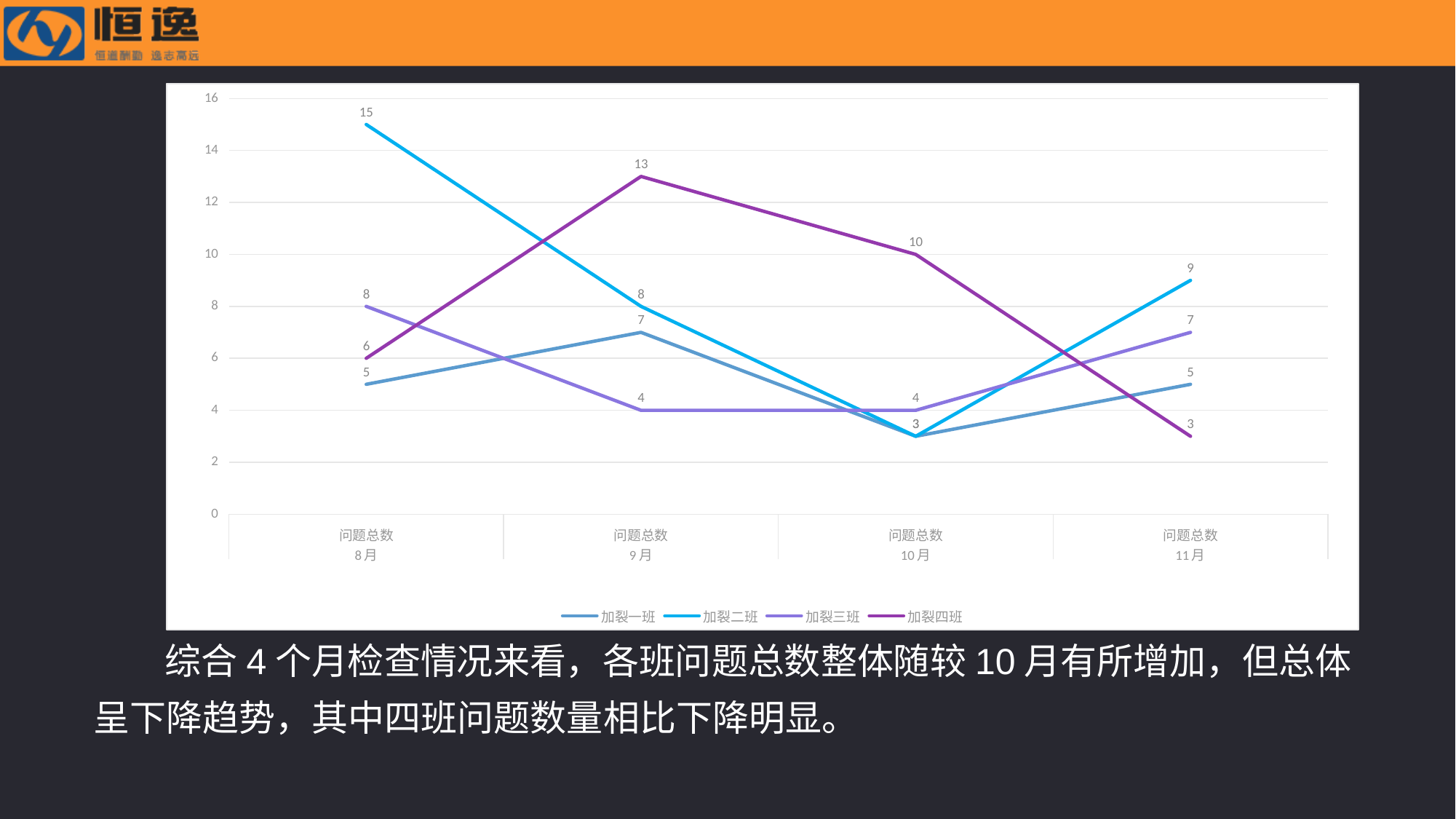
What kind of chart is shown on the slide? line chart What is the value for 加裂二班 in 8月? 15 What is the difference between 加裂四班's value in 9月 and its value in 11月? 10 What is the value for 加裂三班 in 11月? 7 What is the value for 加裂四班 in 9月? 13 Which is larger: 加裂二班 in 11月 or 加裂一班 in 11月? 加裂二班 in 11月 How many series does the legend list? 4 How many months (categories) are plotted along the x axis? 4 What is the value for 加裂一班 in 10月? 3 Which series has the lowest value in 11月? 加裂四班 Which series has the highest value in 8月? 加裂二班 Does the value for 加裂四班 rise or fall from 9月 to 11月? fall